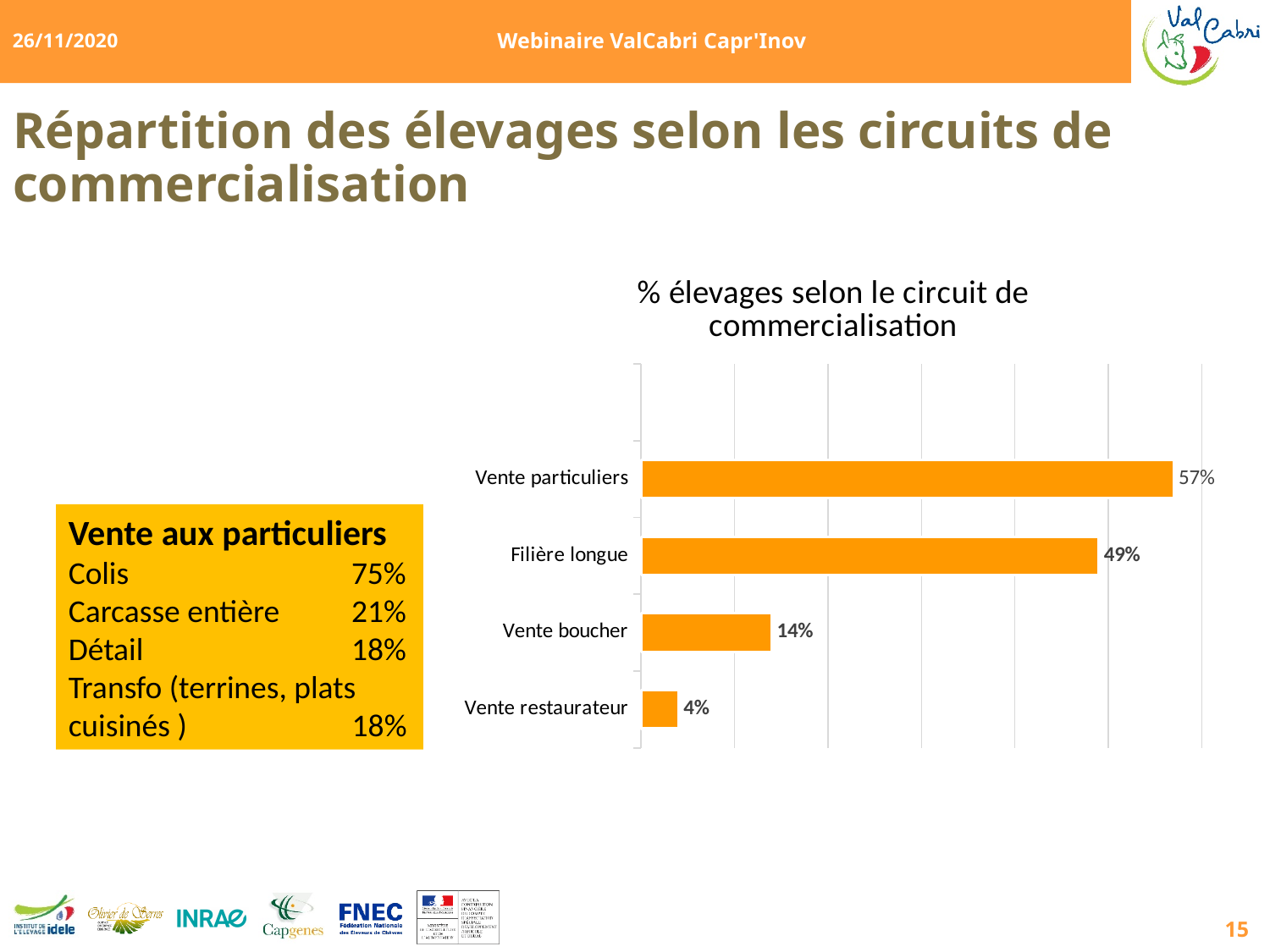
What is the value for Vente restaurateur? 4% What is the difference between the values for Vente boucher and Vente restaurateur? 10% What kind of chart is shown on the slide? Bar chart What is the difference between the values for Vente particuliers and Filière longue? 8% What is the title of the chart? % élevages selon le circuit de commercialisation What is the value for Filière longue? 49% How many categories are shown in the chart? 4 Which category has the lowest value? Vente restaurateur Which category has the highest value? Vente particuliers Which is larger, the value for Filière longue or the value for Vente boucher? Filière longue What is the value for Vente particuliers? 57% What is the value for Vente boucher? 14%